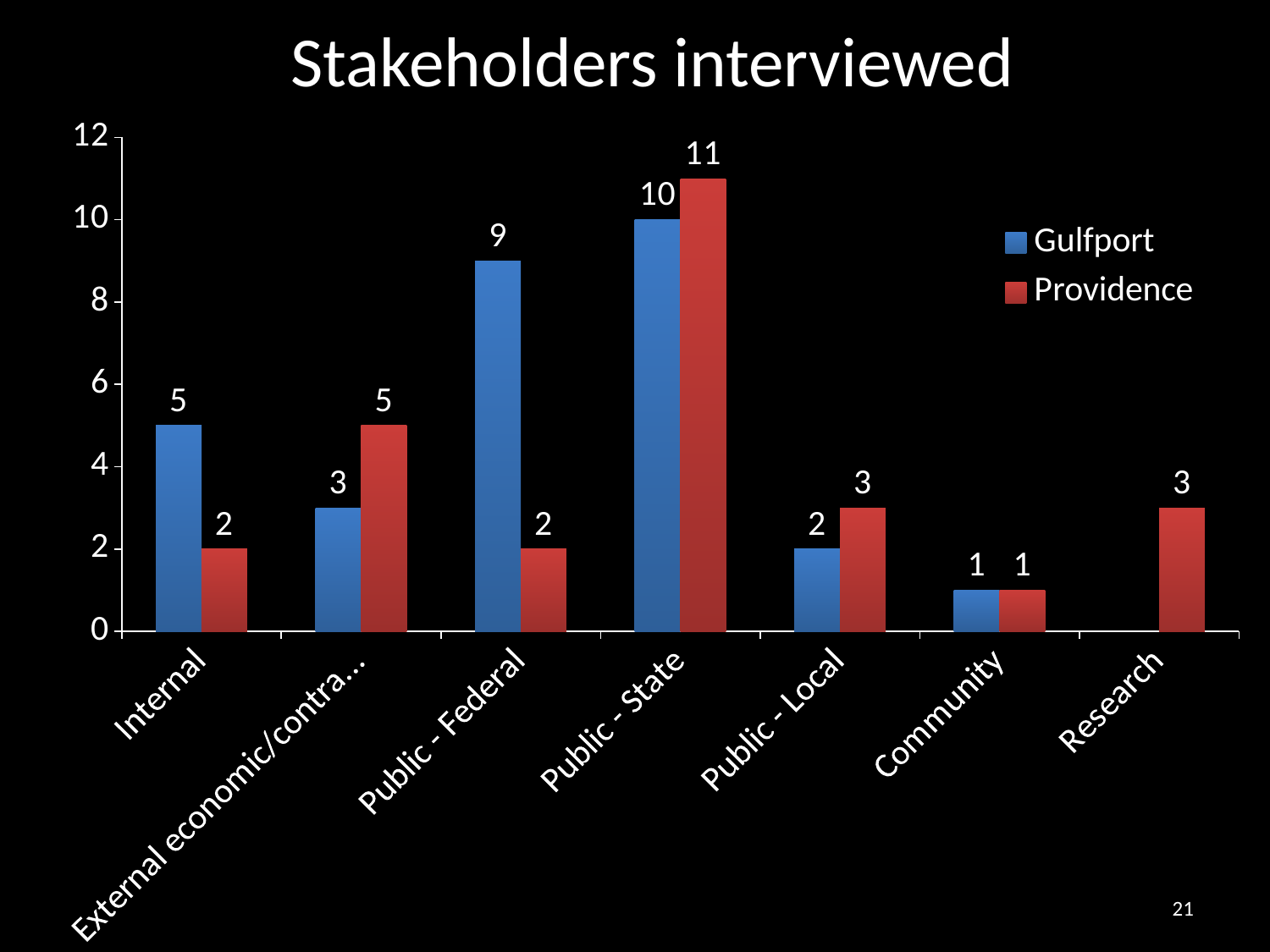
What colour are the Providence bars? Red Which category has the highest Gulfport value? Public - State Which category has the lowest Providence value? Community What is the title of the chart? Stakeholders interviewed For Internal, which series has the larger value, Gulfport or Providence? Gulfport What kind of chart is shown on the slide? Bar chart What is the Providence value for Public - State? 11 What is the Providence value for Internal? 2 What is the Gulfport value for Public - Federal? 9 For Public - Local, which series has the larger value, Gulfport or Providence? Providence What is the difference between the Gulfport and Providence values for Public - Federal? 7 How many series does the legend list? 2